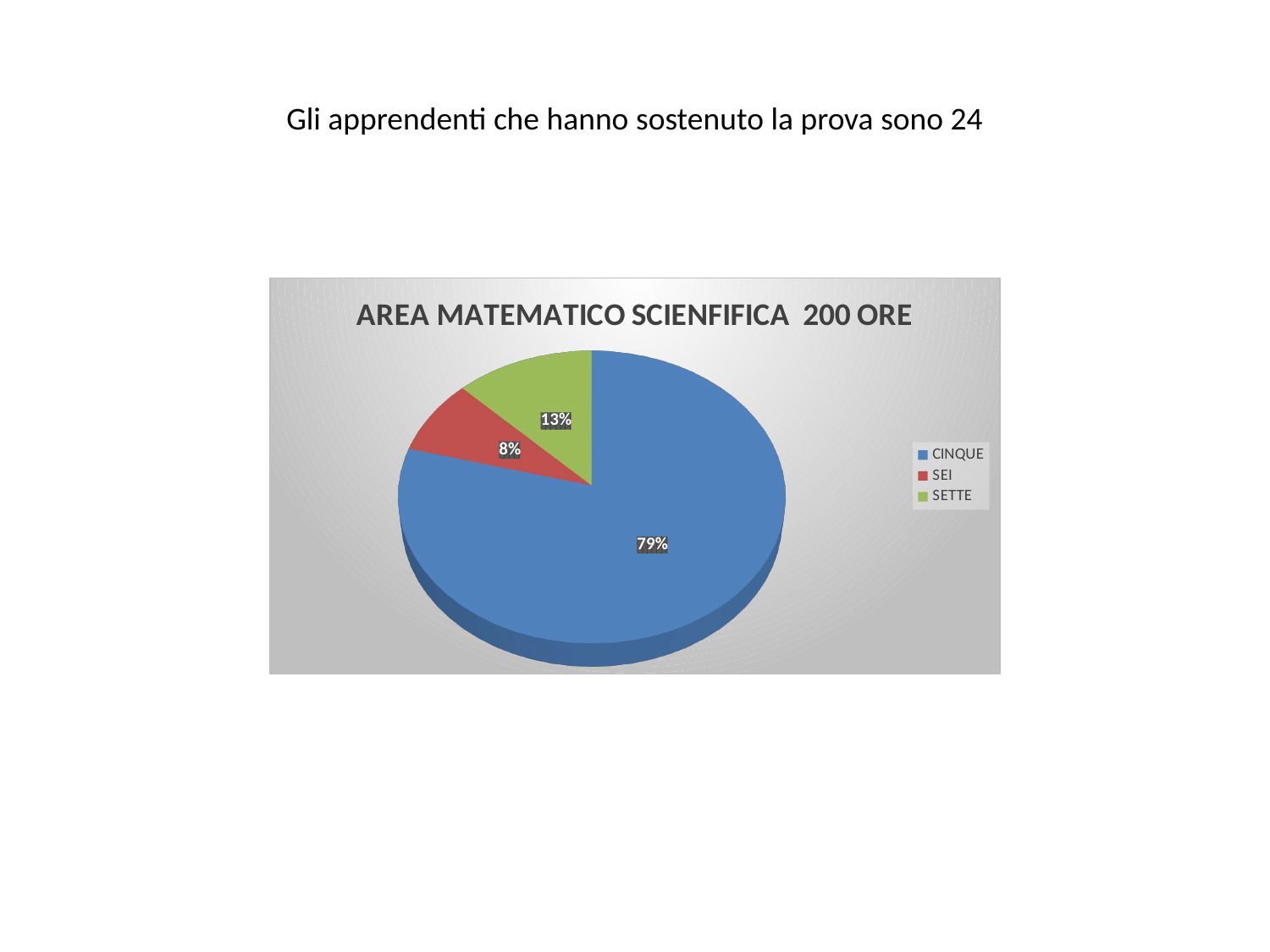
What kind of chart is shown on the slide? Pie chart What is the title of the chart? AREA MATEMATICO SCIENFIFICA 200 ORE What is the difference in percentage points between the CINQUE slice and the SETTE slice? 66 What is the difference in percentage points between the SETTE slice and the SEI slice? 5 Which colour represents SETTE in the chart? Green How many categories does the legend list? 3 Which slice is larger, SEI or SETTE? SETTE What share of the pie does SETTE represent? 13% What share of the pie does CINQUE represent? 79% Which category has the smallest slice of the pie? SEI What share of the pie does SEI represent? 8% Which category has the largest slice of the pie? CINQUE